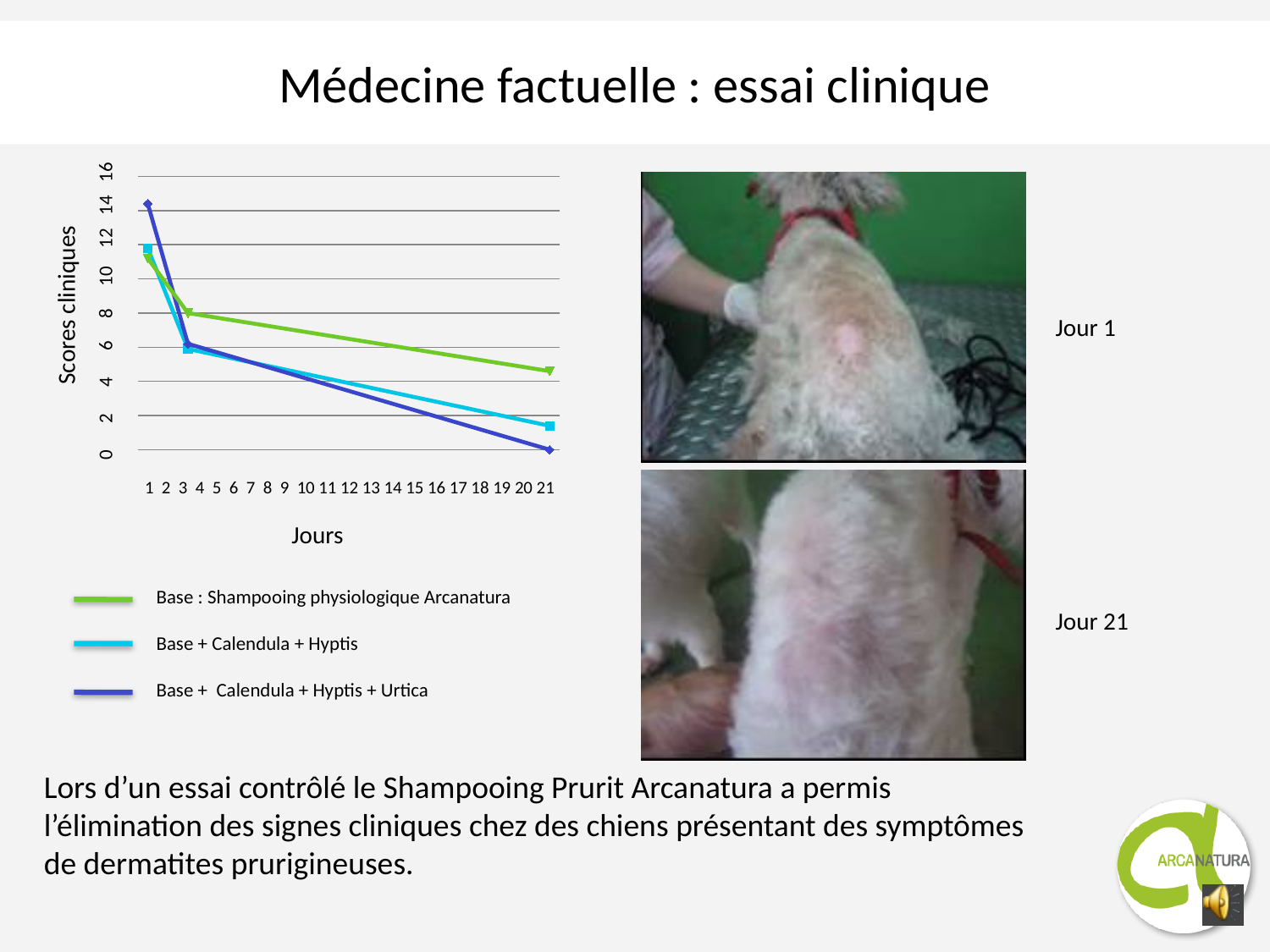
What kind of chart is shown on the slide? line chart What is the title of the x axis? Jours What is the title of the y axis? Scores cliniques Do the clinical scores rise or fall from day 1 to day 21 for all three series? fall Is the value for 'Base : Shampooing physiologique Arcanatura' at day 21 greater or less than 4? greater Is the value for 'Base + Calendula + Hyptis' at day 21 greater or less than 2? less Which series has the lowest clinical score at day 21? Base + Calendula + Hyptis + Urtica Which series has the highest clinical score at day 1? Base + Calendula + Hyptis + Urtica How many series does the legend list? 3 Is the value for 'Base : Shampooing physiologique Arcanatura' at day 3 greater or less than 6? greater At day 21, which is larger: the value for 'Base : Shampooing physiologique Arcanatura' or for 'Base + Calendula + Hyptis + Urtica'? Base : Shampooing physiologique Arcanatura